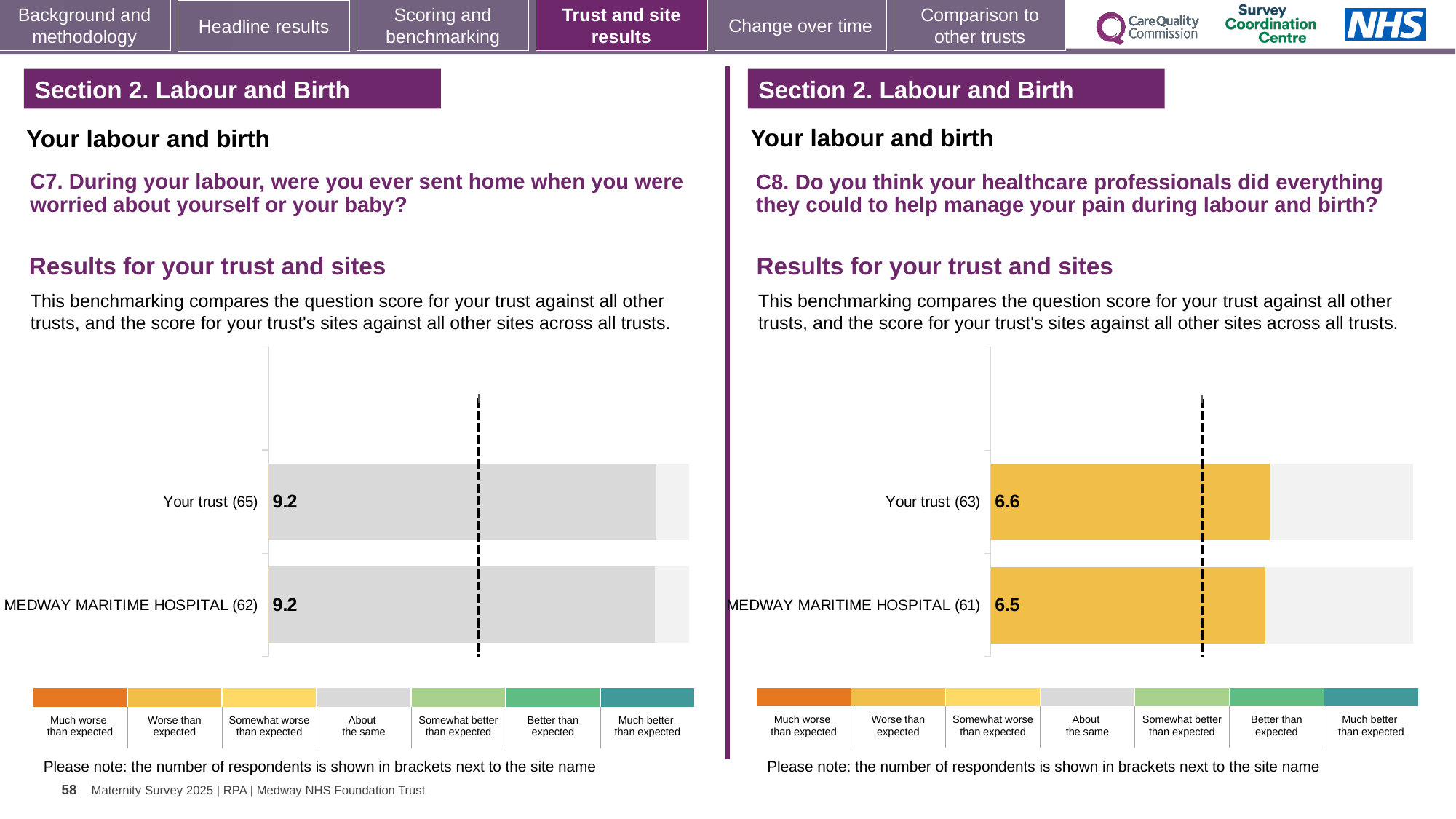
How many bars are plotted on the left chart (C7)? 2 How many bars are plotted on the right chart (C8)? 2 On the right chart (C8), what is the score for Your trust? 6.6 On the left chart (C7), how many respondents are shown in brackets for Your trust? 65 On the left chart (C7), what is the difference between the score for Your trust and the score for MEDWAY MARITIME HOSPITAL? 0 What kind of chart is used on the right (C8)? Bar chart On the right chart (C8), what is the score for MEDWAY MARITIME HOSPITAL? 6.5 On the right chart (C8), which benchmark category does the colour of the bars correspond to in the legend? Worse than expected On the left chart (C7), what is the score for MEDWAY MARITIME HOSPITAL? 9.2 On the left chart (C7), what is the score for Your trust? 9.2 On the right chart (C8), which has the higher score, Your trust or MEDWAY MARITIME HOSPITAL? Your trust On the right chart (C8), what is the difference between the score for Your trust and the score for MEDWAY MARITIME HOSPITAL? 0.1